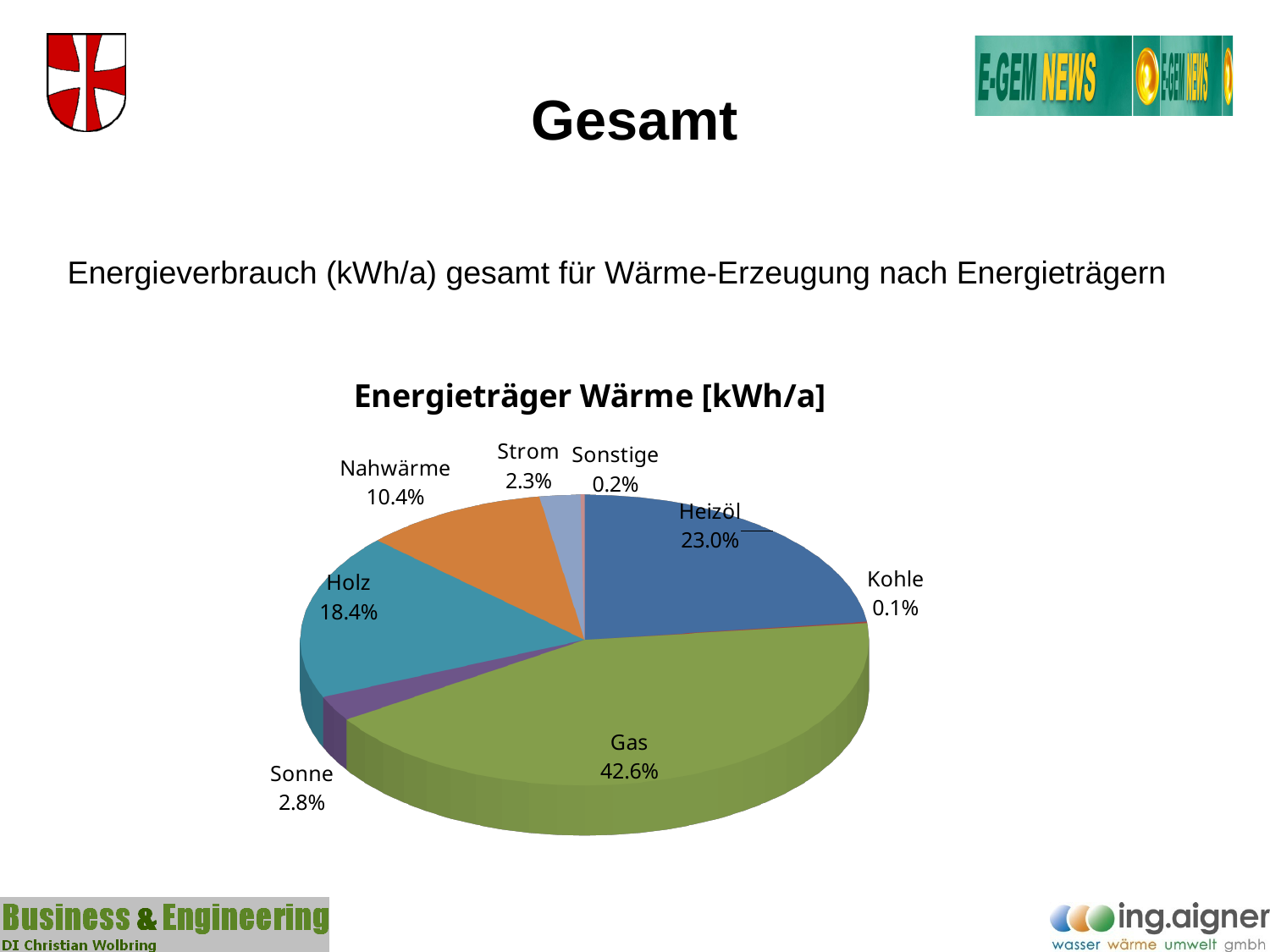
What share of the pie does Holz have? 18.4% How many slices does the pie chart have? 8 What share of the pie does Heizöl have? 23.0% What share of the pie does Nahwärme have? 10.4% Which has a larger share, Holz or Nahwärme? Holz Which energy source has the smallest share of the pie? Kohle What share of the pie does Sonne have? 2.8% What type of chart is shown on the slide? pie chart What is the title of the chart? Energieträger Wärme [kWh/a] What is the difference between the shares of Gas and Heizöl? 19.6% Which energy source has the largest share of the pie? Gas What share of the pie does Gas have? 42.6%